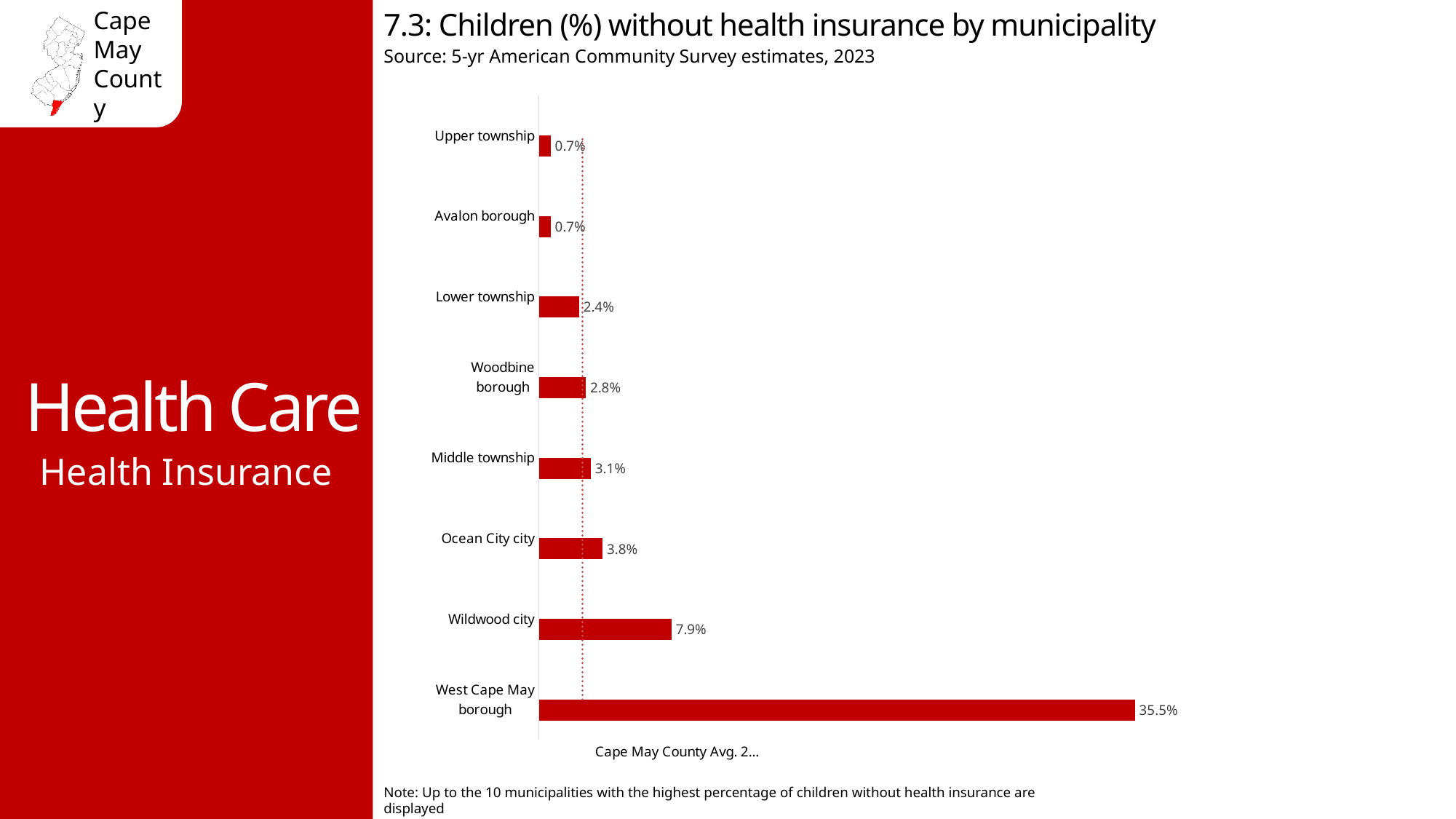
Which has a higher value, Lower township or Woodbine borough? Woodbine borough What is the title of the chart? 7.3: Children (%) without health insurance by municipality What is the value shown for Middle township? 3.1% What does the dotted vertical line in the chart represent? Cape May County Avg. What kind of chart is shown on the slide? Bar chart How many municipalities are shown in the chart? 8 Which municipality has the highest percentage of children without health insurance? West Cape May borough What is the difference between the values for West Cape May borough and Wildwood city? 27.6% Which has a higher value, Ocean City city or Middle township? Ocean City city What is the difference between the values for Ocean City city and Lower township? 1.4% What is the value shown for Woodbine borough? 2.8% What percentage of children are without health insurance in Wildwood city? 7.9%